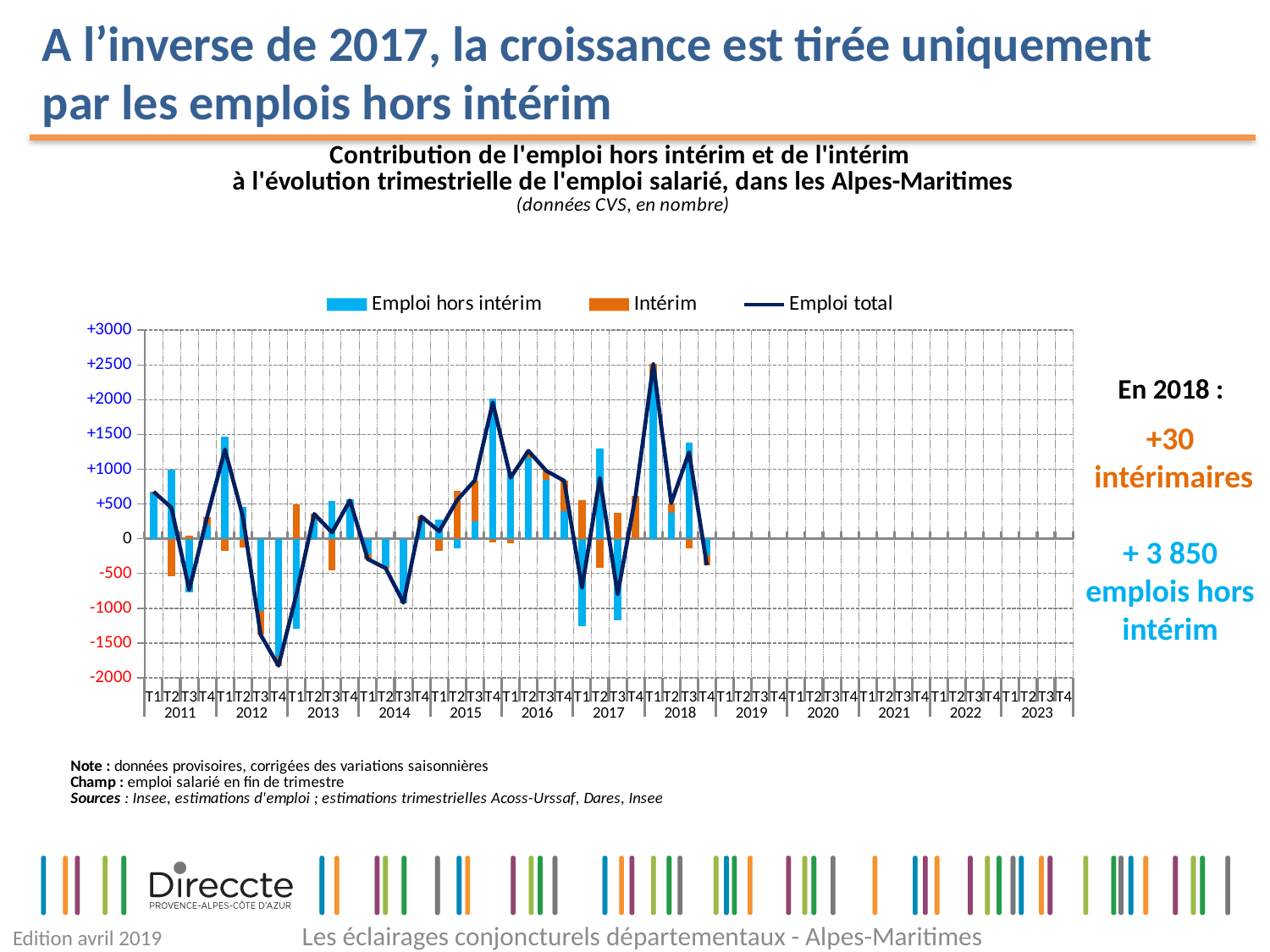
What kind of chart is shown on the slide? A combined bar and line chart What colour are the bars for the Intérim series? Orange In which quarter does the Emploi total line reach its highest value? T1 2018 How many years are labelled along the x axis? 13 Which series is drawn as a line rather than bars? Emploi total How many series does the chart legend list? 3 In which quarter does the Emploi total line reach its lowest value? T4 2012 Is the Emploi total value for T1 2018 greater or less than +2000? greater Is the Emploi hors intérim value for T4 2015 greater or less than +1500? greater Is the Emploi hors intérim value for T1 2017 greater or less than -1000? less Which is larger, the Emploi total value in T1 2018 or in T4 2015? T1 2018